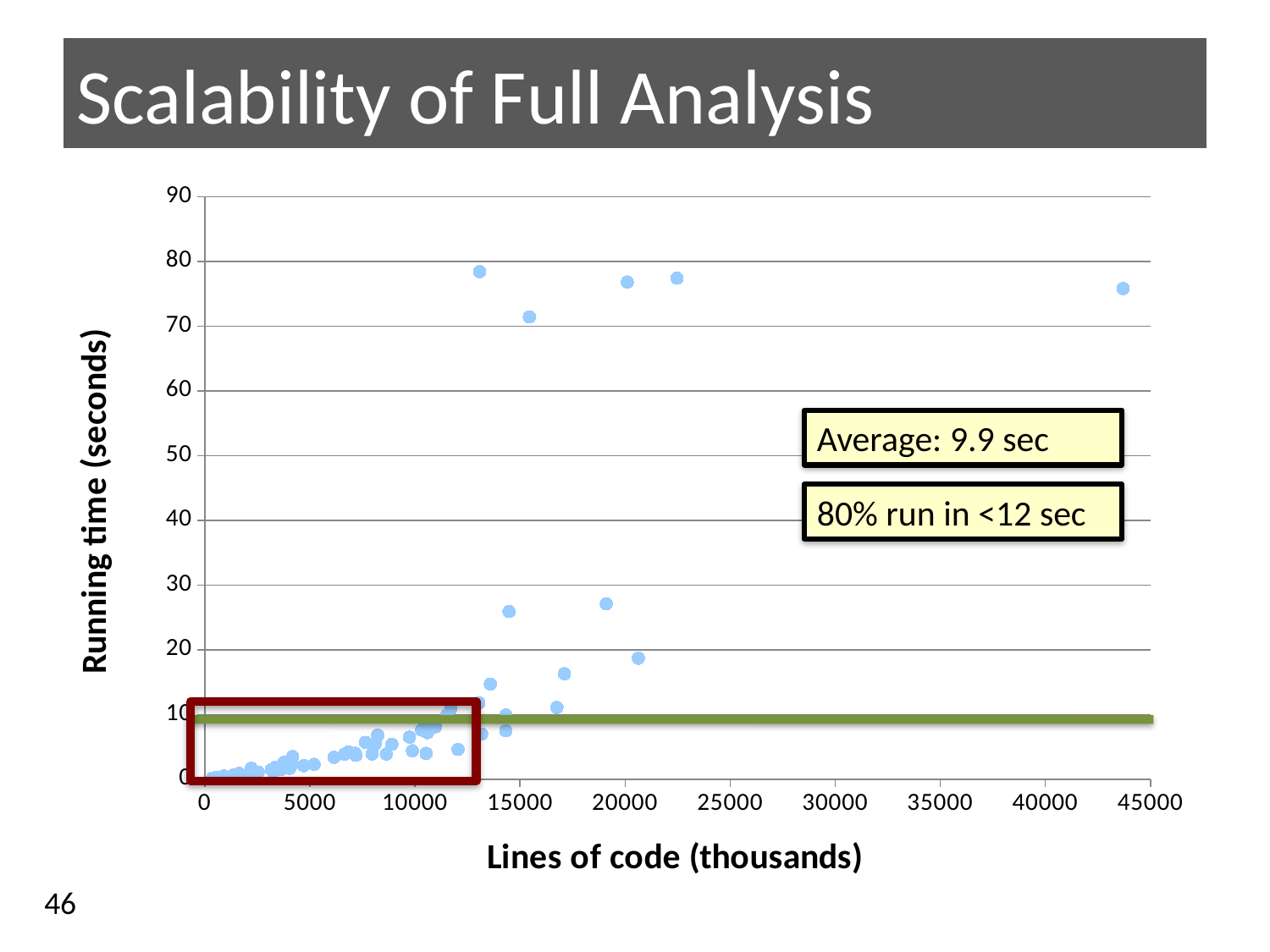
Is the running time for the point at about 20500 thousand lines of code that lies below 30 seconds greater or less than 20 seconds? less Is the running time for the rightmost point (at about 44000 thousand lines of code) greater or less than 70 seconds? greater According to the annotation on the chart, what is the average running time? 9.9 sec Is the running time of the highest point on the chart greater or less than 80 seconds? less What kind of chart is shown on the slide? scatter chart What is the title of the y axis of the chart? Running time (seconds) How many points on the chart have a running time above 70 seconds? 5 According to the annotation on the chart, what percentage of runs complete in under 12 seconds? 80% What is the title of the x axis of the chart? Lines of code (thousands)